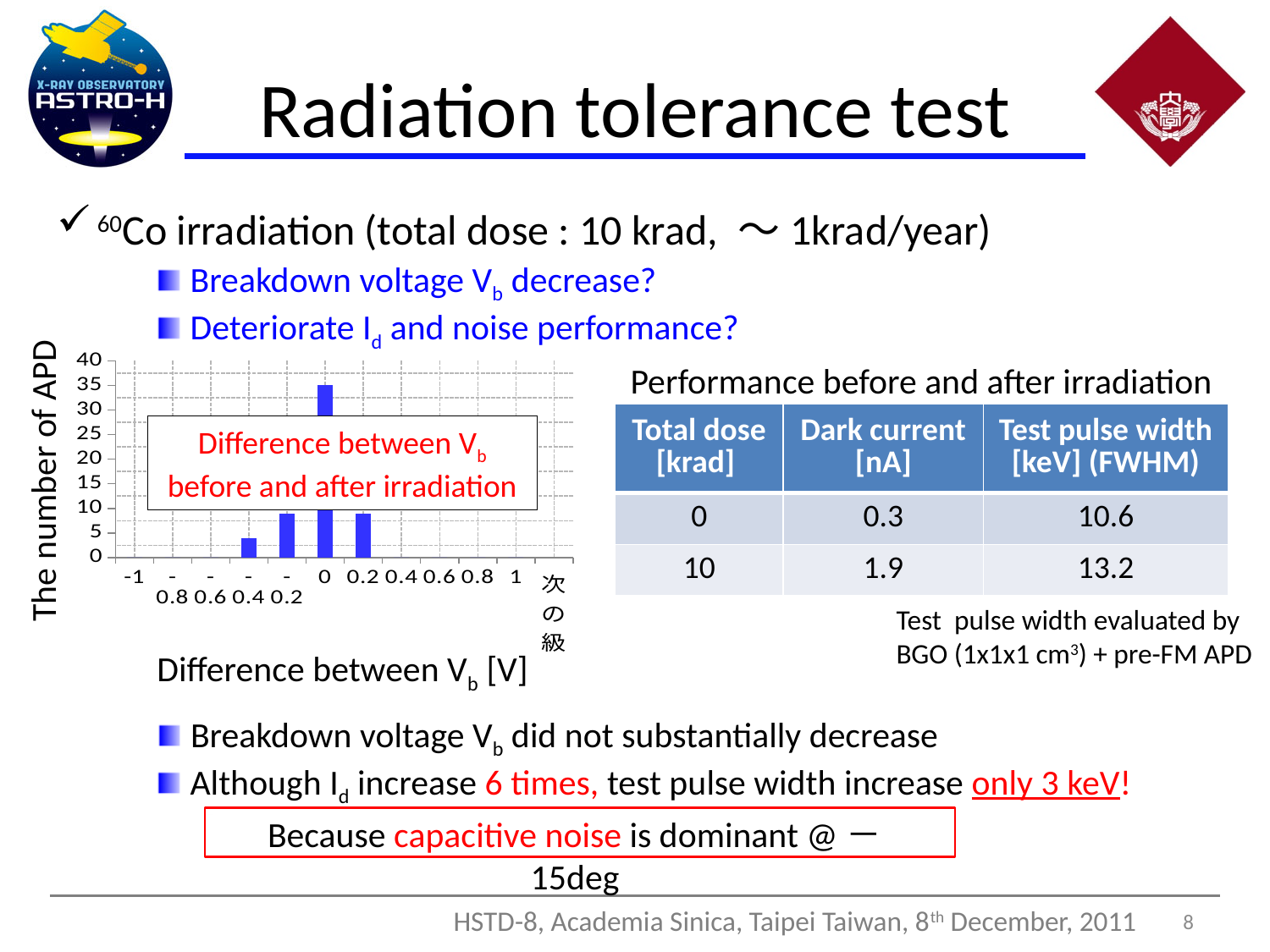
Which bar is taller, the one at 0 or the one at -0.4? 0 Is the value for the bar at 0 greater or less than 30? greater Is the value for the bar at -0.2 greater or less than 5? greater How many tick labels are shown along the x axis of the chart? 12 What is the maximum value shown on the vertical axis of the chart? 40 What kind of chart is shown on the slide? bar chart What is the label of the vertical axis of the chart? The number of APD Which x-axis category has the highest bar in the chart? 0 How many bars are plotted in the chart? 4